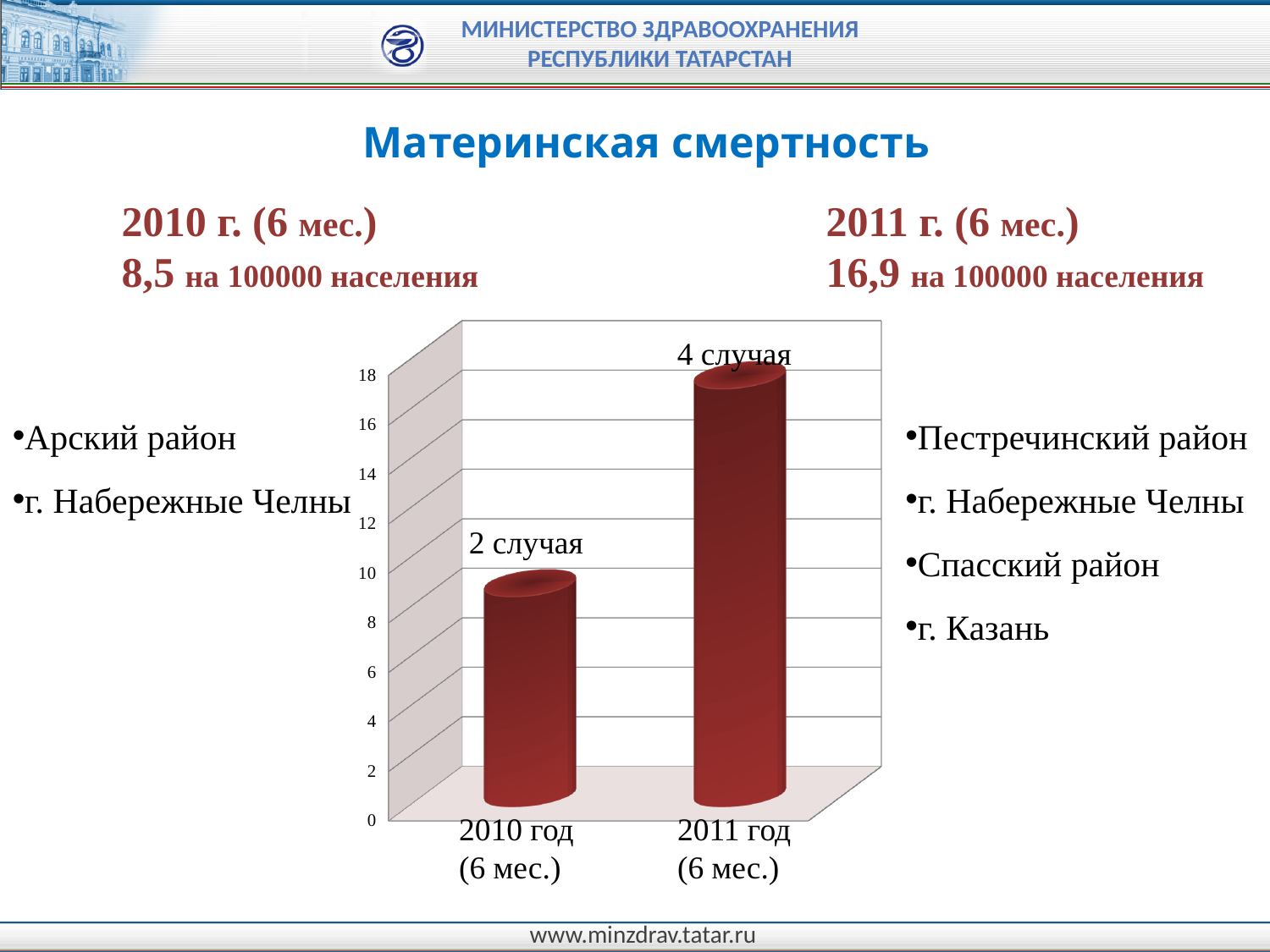
How many bars (categories) does the chart show? 2 What is the title of the slide above the chart? Материнская смертность Which category has the shortest bar? 2010 год (6 мес.) How many more cases are labelled for 2011 год (6 мес.) than for 2010 год (6 мес.)? 2 What data label is printed above the bar for 2010 год (6 мес.)? 2 случая Which category has the tallest bar? 2011 год (6 мес.) What kind of chart is shown on the slide? bar chart Is the bar for 2011 год (6 мес.) greater or less than 14 on the axis? greater Do the bars rise or fall from 2010 to 2011? rise What data label is printed above the bar for 2011 год (6 мес.)? 4 случая Which bar is taller, 2010 год (6 мес.) or 2011 год (6 мес.)? 2011 год (6 мес.) Is the bar for 2010 год (6 мес.) greater or less than 12 on the axis? less